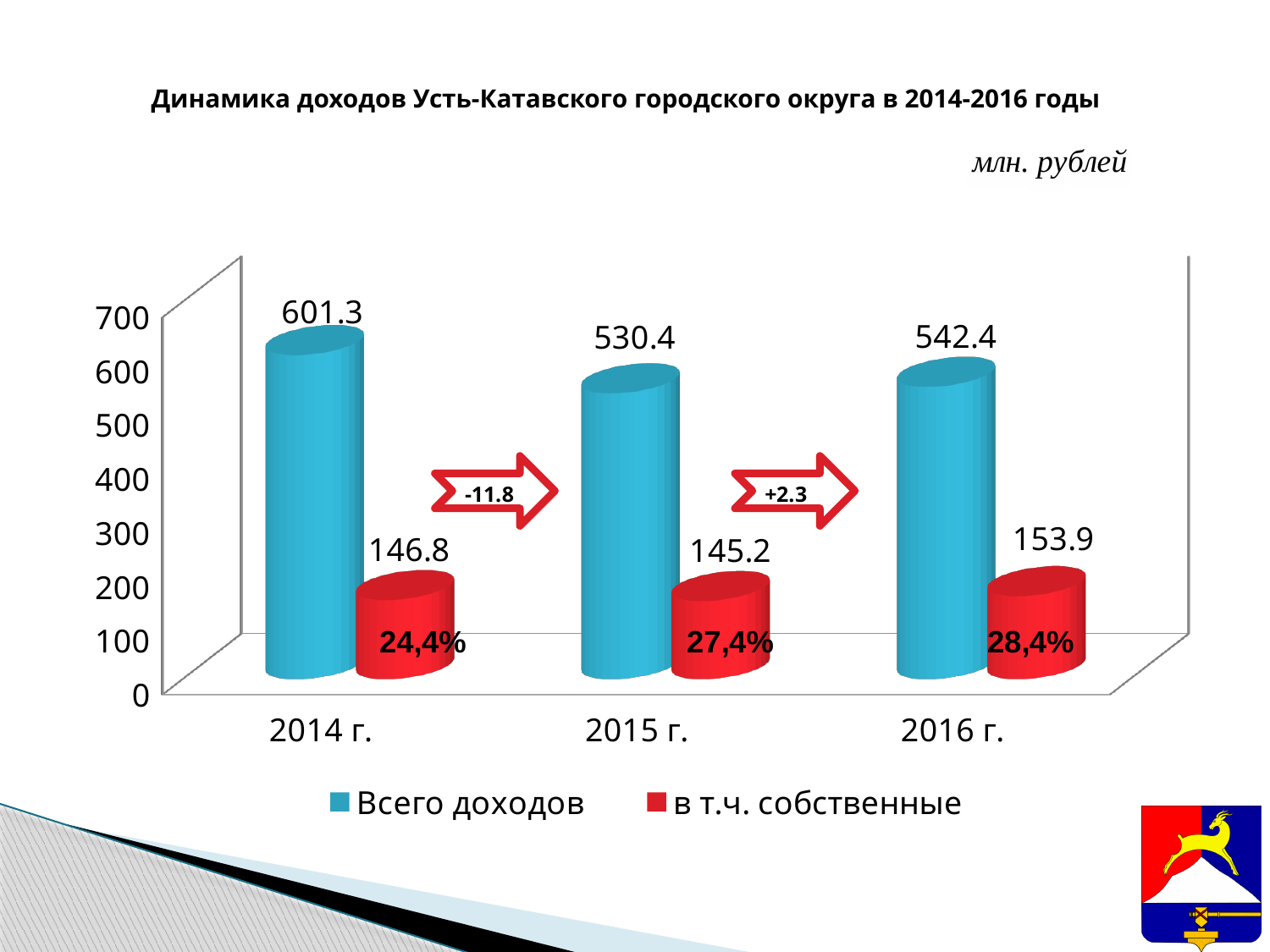
What is the value of "в т.ч. собственные" for 2016 г.? 153.9 What kind of chart is shown on the slide? Bar chart What unit is stated above the chart? млн. рублей In which year is "Всего доходов" highest? 2014 г. What is the value of "Всего доходов" for 2015 г.? 530.4 Which is larger: "Всего доходов" in 2016 г. or in 2015 г.? 2016 г. What is the value of "Всего доходов" for 2014 г.? 601.3 What is the difference between "Всего доходов" in 2014 г. and 2015 г.? 70.9 How many series does the legend list? 2 What percentage label is shown on the red bar for 2015 г.? 27,4% In which year is "в т.ч. собственные" lowest? 2015 г. How many years are shown on the x axis? 3